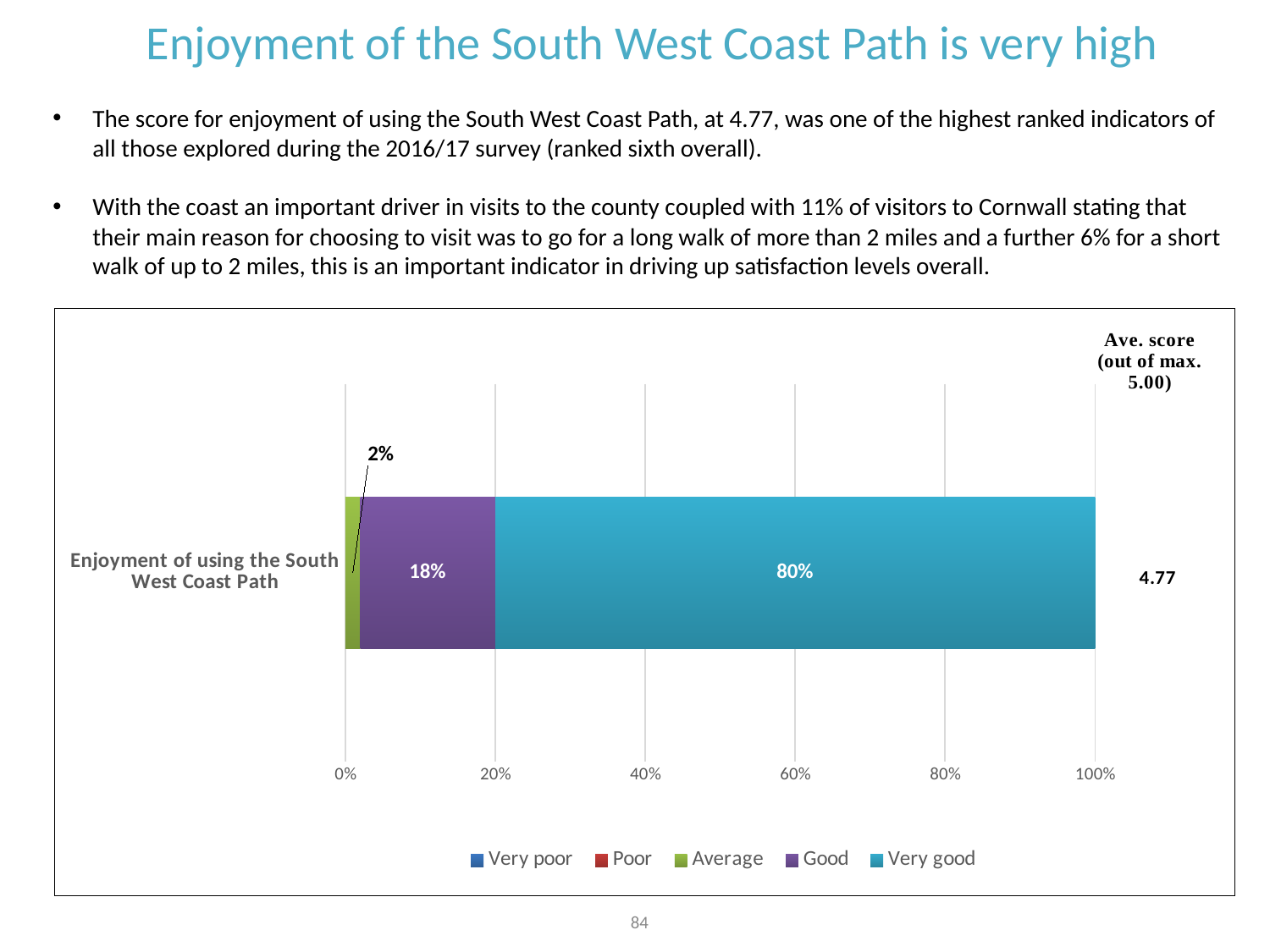
What is the difference in percentage points between the 'Very good' and 'Good' shares? 62 Is the 'Very good' share greater or less than 60%? greater What is the combined total of the 'Average', 'Good' and 'Very good' shares? 100% What percentage of respondents rated enjoyment of using the South West Coast Path as 'Very good'? 80% What is the average score (out of max. 5.00) shown for enjoyment of using the South West Coast Path? 4.77 What percentage of respondents rated enjoyment of using the South West Coast Path as 'Good'? 18% Which rating category has the largest share of the bar for enjoyment of using the South West Coast Path? Very good Which of the labelled rating categories has the smallest share of the bar? Average What percentage of respondents rated enjoyment of using the South West Coast Path as 'Average'? 2% How many series does the legend list? 5 Which is larger, the 'Good' share or the 'Average' share? Good What kind of chart is shown on the slide? Stacked bar chart